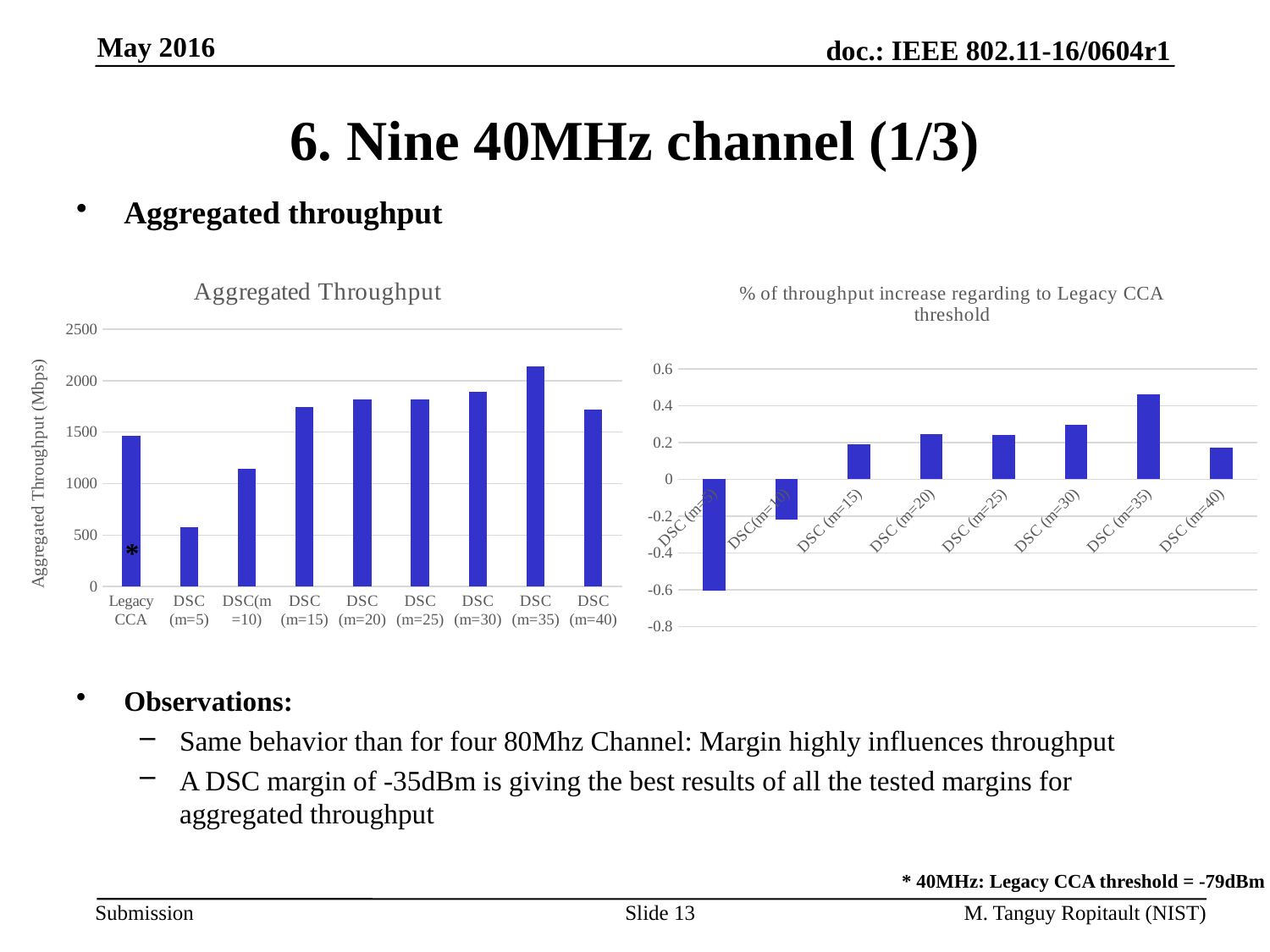
In the "Aggregated Throughput" chart, which category has the highest bar? DSC (m=35) In the "Aggregated Throughput" chart, is the value for DSC (m=5) greater or less than 1000? less How many categories are shown on the x axis of the "Aggregated Throughput" chart? 9 In the "Aggregated Throughput" chart, which category has the lowest bar? DSC (m=5) What kind of chart is the "Aggregated Throughput" chart on the left? bar chart In the "% of throughput increase regarding to Legacy CCA threshold" chart, which category has the highest bar? DSC (m=35) In the "Aggregated Throughput" chart, is the value for Legacy CCA greater or less than 1000? greater How many categories are shown in the "% of throughput increase regarding to Legacy CCA threshold" chart on the right? 8 In the "% of throughput increase regarding to Legacy CCA threshold" chart, is the value for DSC (m=35) greater or less than 0.4? greater What is the y-axis label of the "Aggregated Throughput" chart? Aggregated Throughput (Mbps) In the "Aggregated Throughput" chart, which is larger: the value for Legacy CCA or the value for DSC(m=10)? Legacy CCA